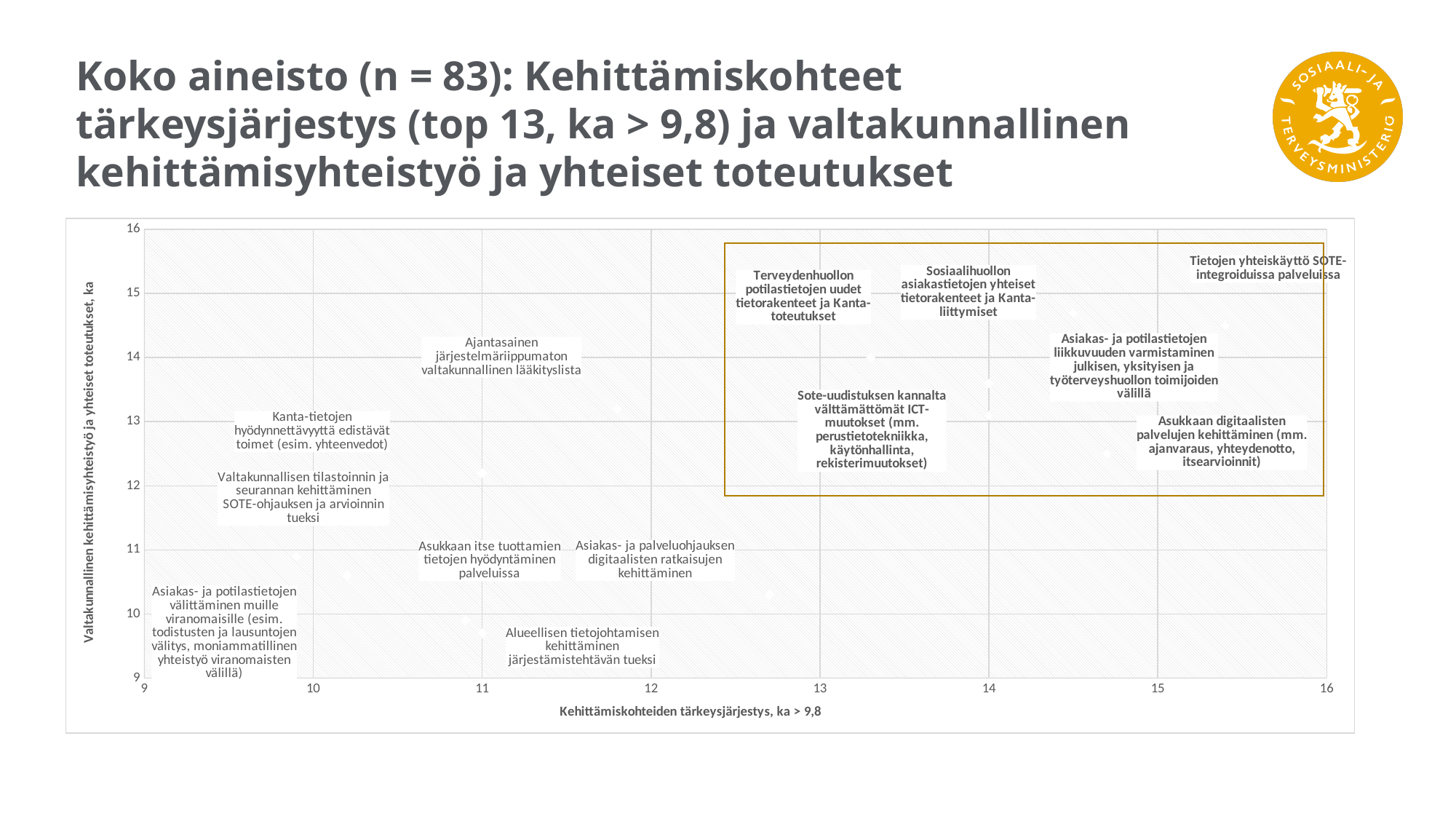
Is the vertical-axis value for "Ajantasainen järjestelmäriippumaton valtakunnallinen lääkityslista" greater or less than 12? greater How many development targets (data points) are plotted on the chart? 13 Is the horizontal-axis value for "Tietojen yhteiskäyttö SOTE-integroiduissa palveluissa" greater or less than 14? greater Is the vertical-axis value for "Alueellisen tietojohtamisen kehittäminen järjestämistehtävän tueksi" greater or less than 11? less What is the title of the vertical axis of the chart? Valtakunnallinen kehittämisyhteistyö ja yhteiset toteutukset, ka What kind of chart is shown on the slide? scatter chart What is the title of the horizontal axis of the chart? Kehittämiskohteiden tärkeysjärjestys, ka > 9,8 Which is plotted further right on the horizontal axis: "Asukkaan digitaalisten palvelujen kehittäminen" or "Kanta-tietojen hyödynnettävyyttä edistävät toimet"? Asukkaan digitaalisten palvelujen kehittäminen Which is plotted higher on the vertical axis: "Tietojen yhteiskäyttö SOTE-integroiduissa palveluissa" or "Alueellisen tietojohtamisen kehittäminen järjestämistehtävän tueksi"? Tietojen yhteiskäyttö SOTE-integroiduissa palveluissa Which development target is plotted highest on the vertical axis? Tietojen yhteiskäyttö SOTE-integroiduissa palveluissa What is the lowest value shown on the horizontal axis of the chart? 9